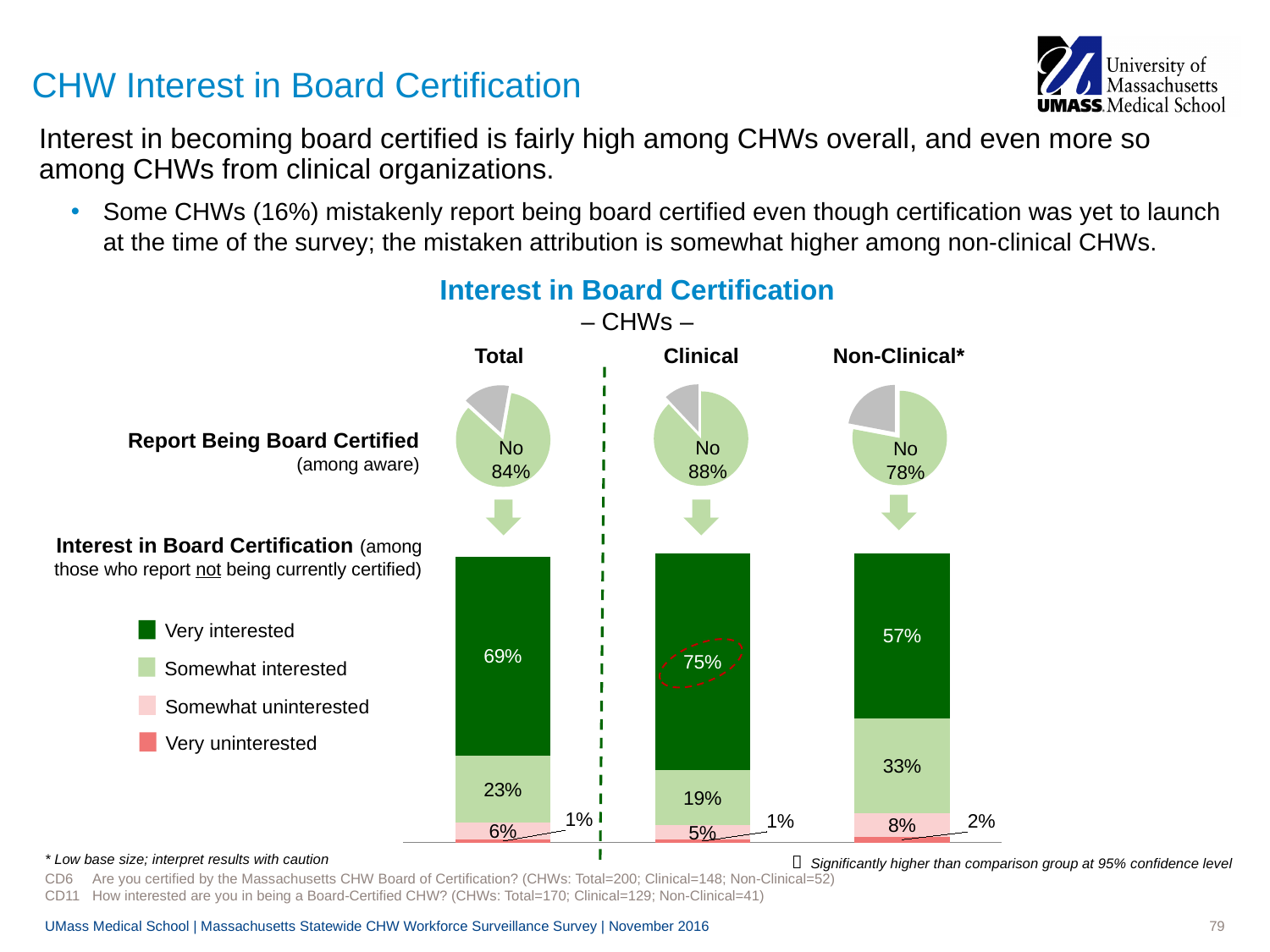
In the stacked bar chart, which group has the highest share of Very interested CHWs? Clinical What type of chart shows the interest in board certification by group? Stacked bar chart In the stacked bar chart, what is the difference in the Very interested share between Clinical and Non-Clinical CHWs? 18 percentage points How many interest categories does the legend of the stacked bar chart list? 4 In the 'Report Being Board Certified' pie charts, what percentage of Clinical CHWs answered No? 88% Among the 'Report Being Board Certified' pie charts, which group has the highest share answering No? Clinical In the stacked bar chart, what percentage of Clinical CHWs are Somewhat uninterested? 5% How many groups (bars) are shown in the stacked bar chart on interest in board certification? 3 In the stacked bar chart, is the Somewhat interested share larger for Total or for Clinical CHWs? Total In the stacked bar chart, what percentage of Non-Clinical CHWs are Somewhat interested? 33% In the stacked bar chart on interest in board certification, what percentage of Total CHWs are Very interested? 69% In the stacked bar chart, which group has the lowest share of Very interested CHWs? Non-Clinical*